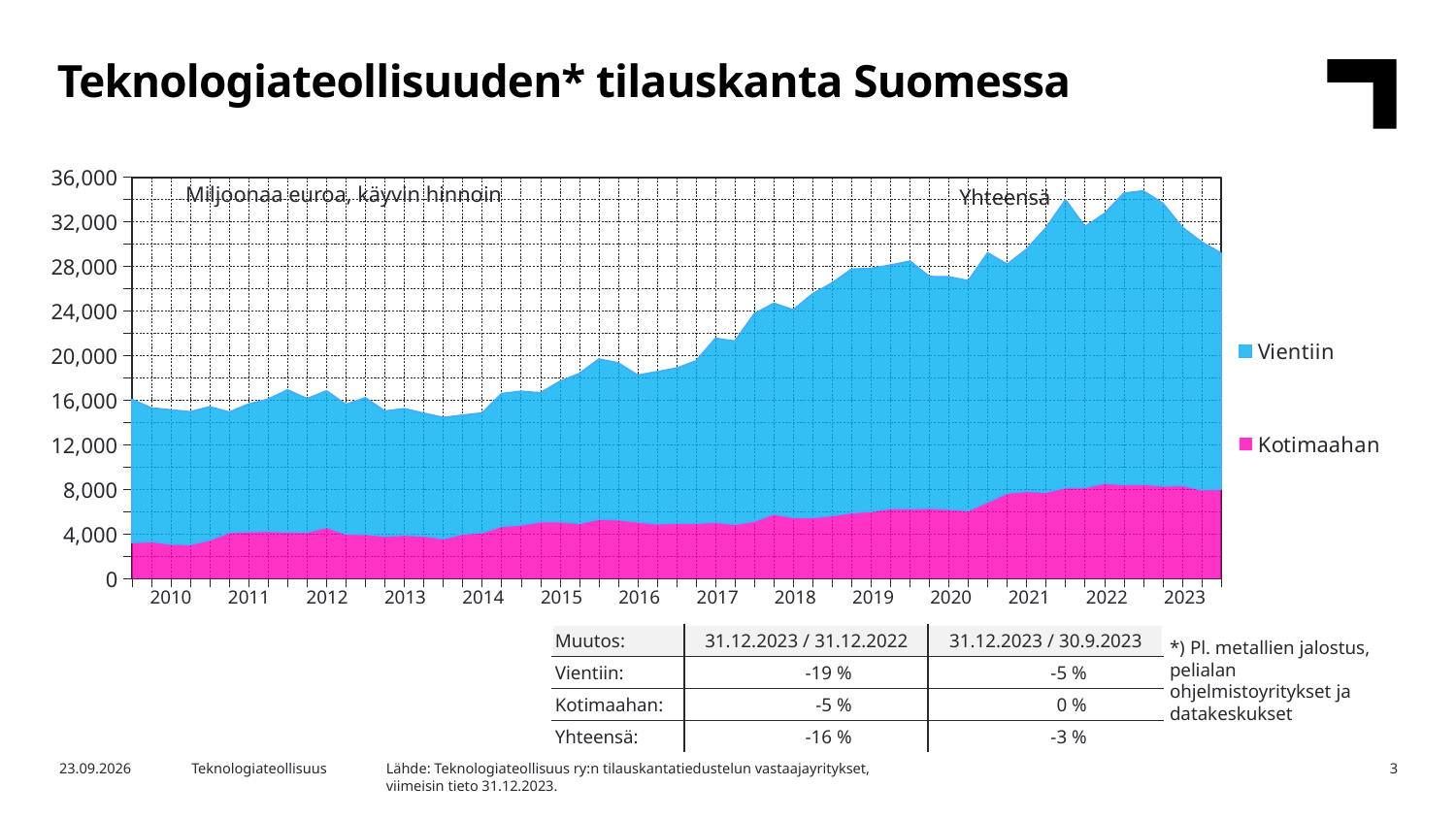
What unit label is shown inside the chart area? Miljoonaa euroa, käyvin hinnoin Is the peak total (Yhteensä) value in 2022 greater or less than 32,000? greater Which two series are listed in the chart legend? Vientiin and Kotimaahan Is the Kotimaahan value at the start of 2010 greater or less than 4,000? less Is the total (Yhteensä) value at the end of 2023 greater or less than 32,000? less How many years are labelled on the x axis of the chart? 14 How many series does the chart legend list? 2 Does the total order book (Yhteensä) generally rise or fall from 2010 to 2022? rise Which series is larger throughout the chart, Vientiin or Kotimaahan? Vientiin What kind of chart is shown on the slide? Stacked area chart